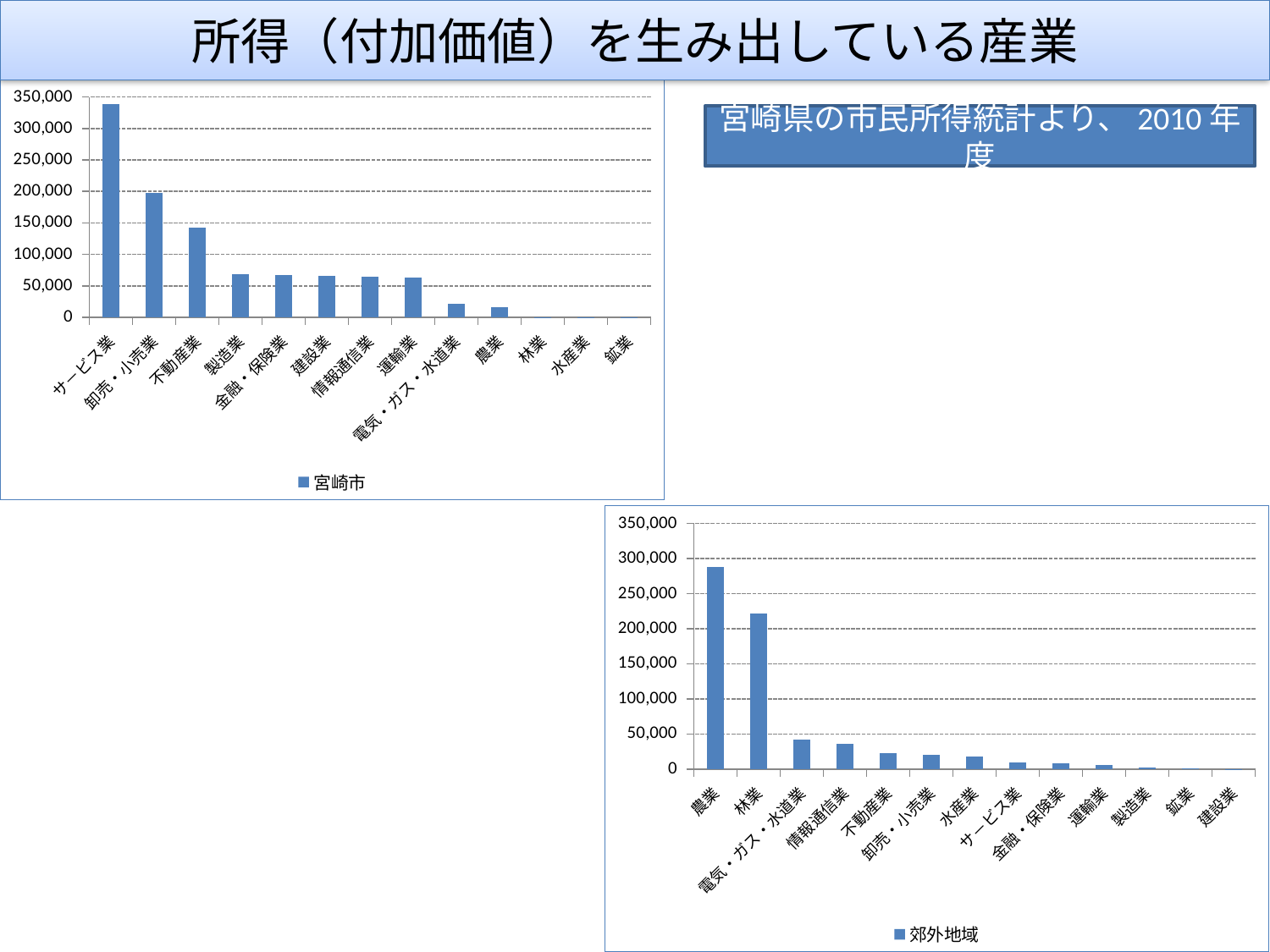
How many series does the legend of the bottom-right chart list? 1 In the bottom-right chart (郊外地域), is the value for 電気・ガス・水道業 greater or less than 50,000? less What is the legend entry of the bottom-right chart? 郊外地域 In the top-left chart (宮崎市), do the values rise or fall from left to right along the x axis? fall In the top-left chart (宮崎市), is the value for 卸売・小売業 greater or less than 150,000? greater What kind of chart is the top-left chart with the legend 宮崎市? bar chart In the top-left chart (宮崎市), is the value for サービス業 greater or less than 300,000? greater In the bottom-right chart (郊外地域), which industry has the highest value? 農業 In the top-left chart (宮崎市), which industry has the highest value? サービス業 In the top-left chart (宮崎市), which is larger, the value for 不動産業 or the value for 製造業? 不動産業 How many industry categories are shown on the x axis of the top-left chart (宮崎市)? 13